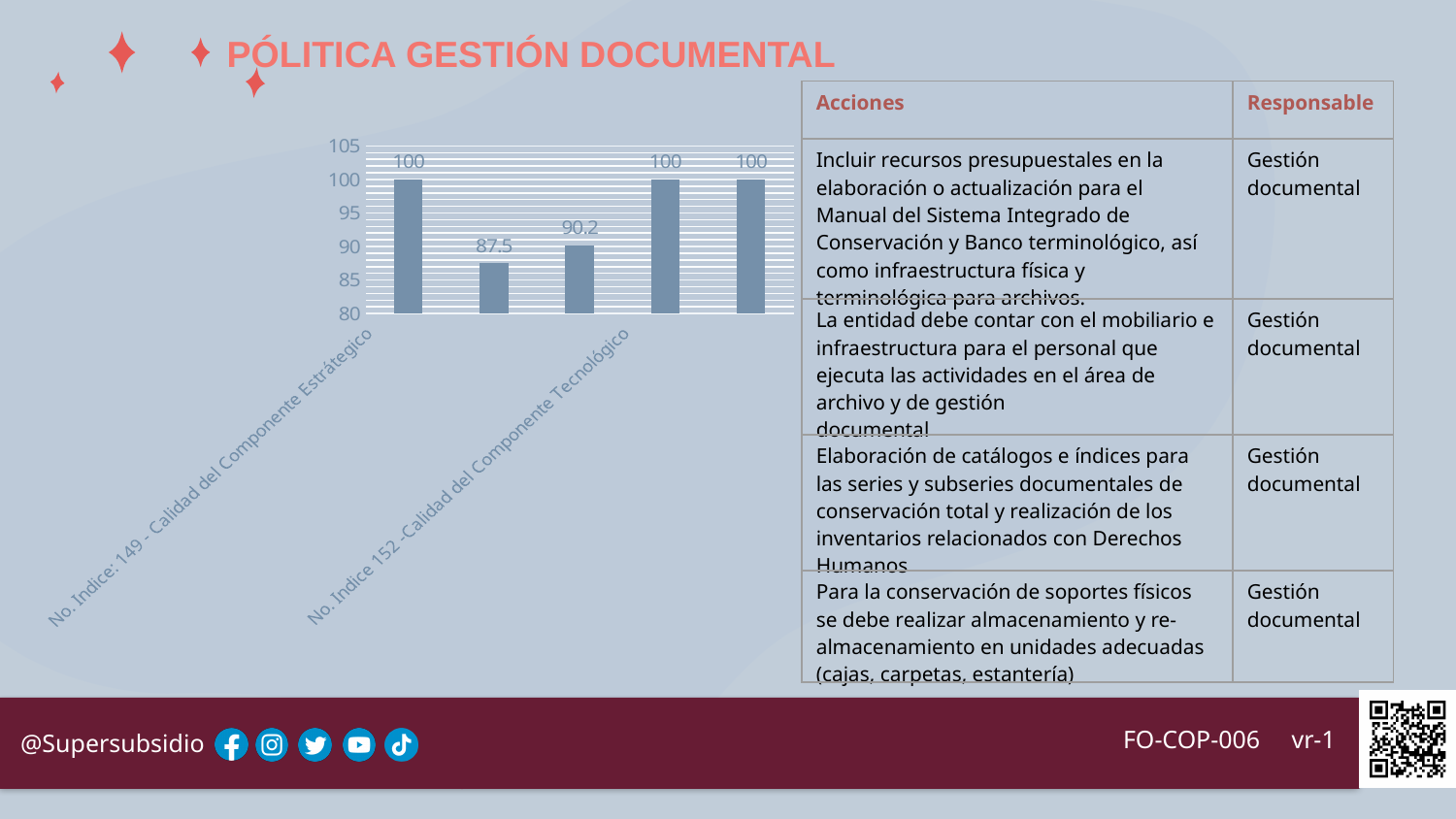
How many bars in the chart have a value of 100? 3 Is the value of the second bar greater or less than 90? less Which is larger, the second bar or the third bar? the third bar What is the value of the third bar from the left in the chart? 90.2 What is the highest value shown in the chart? 100 What is the value of the first (leftmost) bar in the chart? 100 What is the difference between the third bar (90.2) and the second bar (87.5)? 2.7 What is the lowest value shown in the chart? 87.5 What type of chart is shown on the slide? bar chart How many bars are plotted in the chart? 5 What is the value of the second bar from the left in the chart? 87.5 What is the difference between the first bar (100) and the second bar (87.5)? 12.5